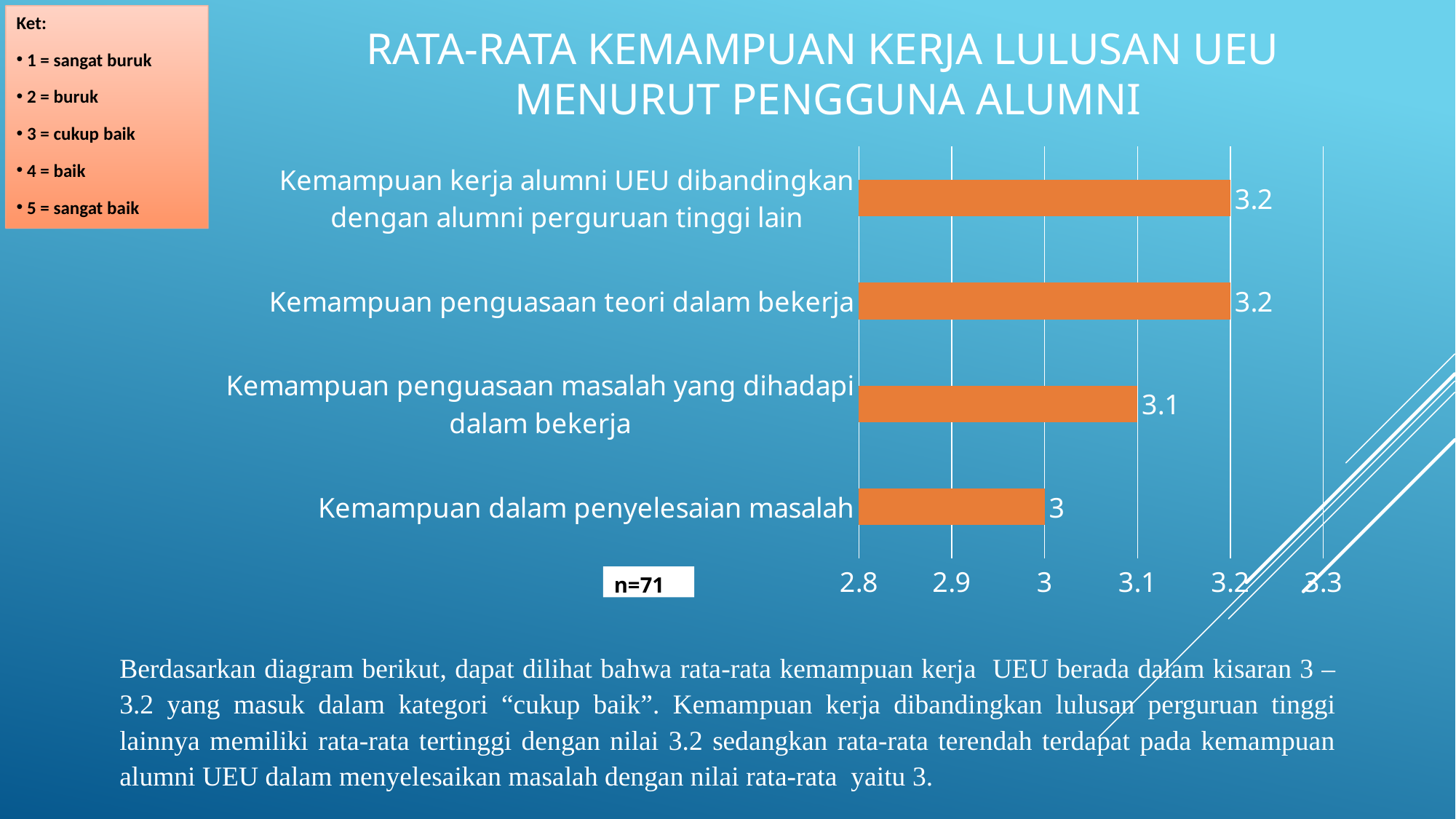
What is the value for "Kemampuan penguasaan masalah yang dihadapi dalam bekerja"? 3.1 What is the difference between the value for "Kemampuan penguasaan masalah yang dihadapi dalam bekerja" and the value for "Kemampuan dalam penyelesaian masalah"? 0.1 What is the value for "Kemampuan dalam penyelesaian masalah"? 3 Is the value for "Kemampuan penguasaan masalah yang dihadapi dalam bekerja" greater or less than 3? greater What is the difference between the value for "Kemampuan penguasaan teori dalam bekerja" and the value for "Kemampuan dalam penyelesaian masalah"? 0.2 What is the value for "Kemampuan penguasaan teori dalam bekerja"? 3.2 Which category has the lowest value? Kemampuan dalam penyelesaian masalah What is the value for "Kemampuan kerja alumni UEU dibandingkan dengan alumni perguruan tinggi lain"? 3.2 What is the title of the chart on the slide? RATA-RATA KEMAMPUAN KERJA LULUSAN UEU MENURUT PENGGUNA ALUMNI How many categories are shown in the chart? 4 Which is larger: the value for "Kemampuan penguasaan teori dalam bekerja" or the value for "Kemampuan penguasaan masalah yang dihadapi dalam bekerja"? Kemampuan penguasaan teori dalam bekerja What kind of chart is shown on the slide? Bar chart